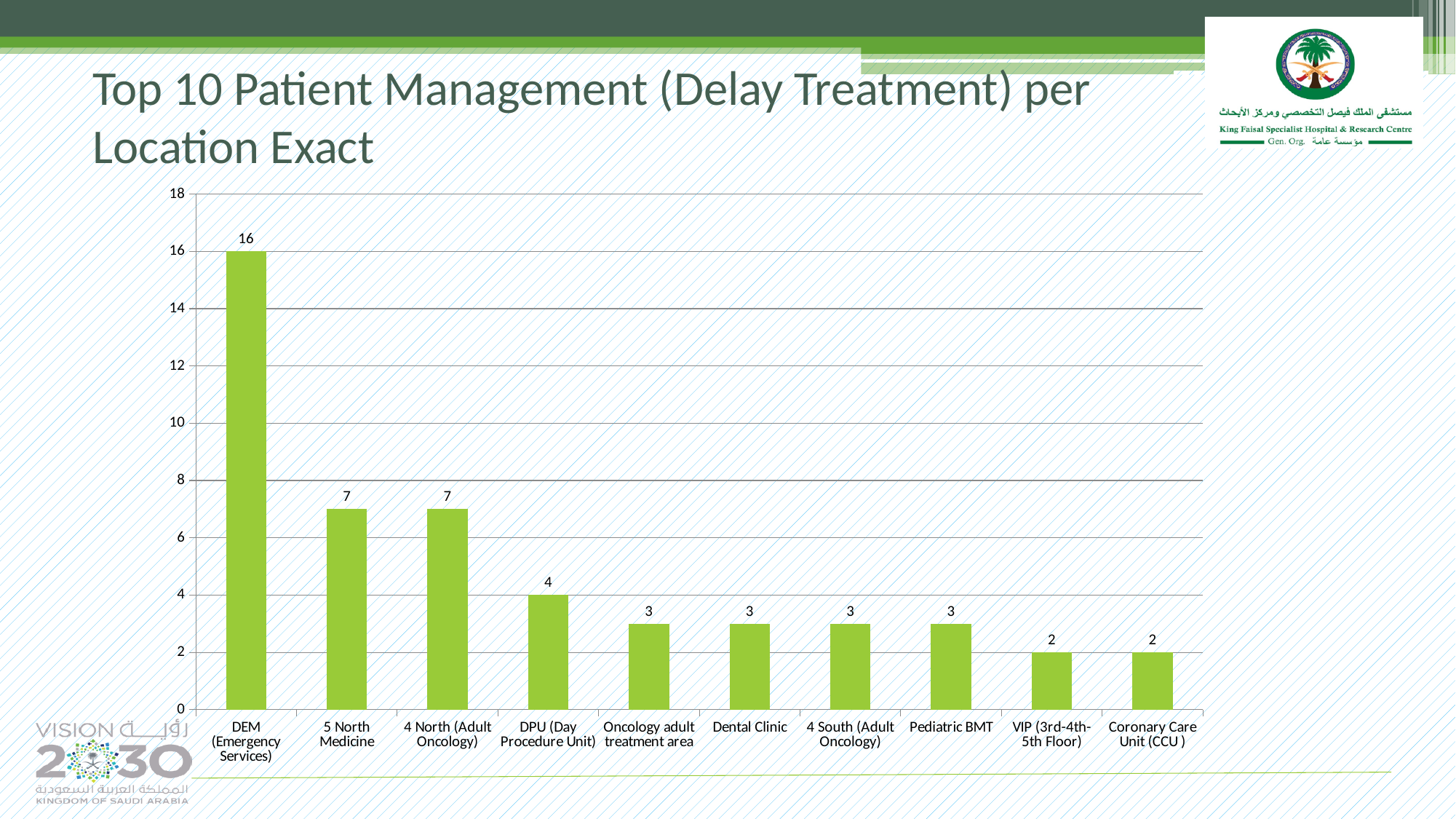
What is the difference between the values for DPU (Day Procedure Unit) and VIP (3rd-4th-5th Floor)? 2 What is the difference between the values for DEM (Emergency Services) and 5 North Medicine? 9 What is the title of the slide? Top 10 Patient Management (Delay Treatment) per Location Exact What kind of chart is shown on the slide? Bar chart What is the value for Pediatric BMT? 3 Is the value for DEM (Emergency Services) greater or less than 14? greater Which is larger, the value for 4 North (Adult Oncology) or the value for Dental Clinic? 4 North (Adult Oncology) What is the value for DPU (Day Procedure Unit)? 4 What is the value for Coronary Care Unit (CCU)? 2 Which location has the highest value? DEM (Emergency Services) What is the value for DEM (Emergency Services)? 16 How many locations are shown on the chart? 10